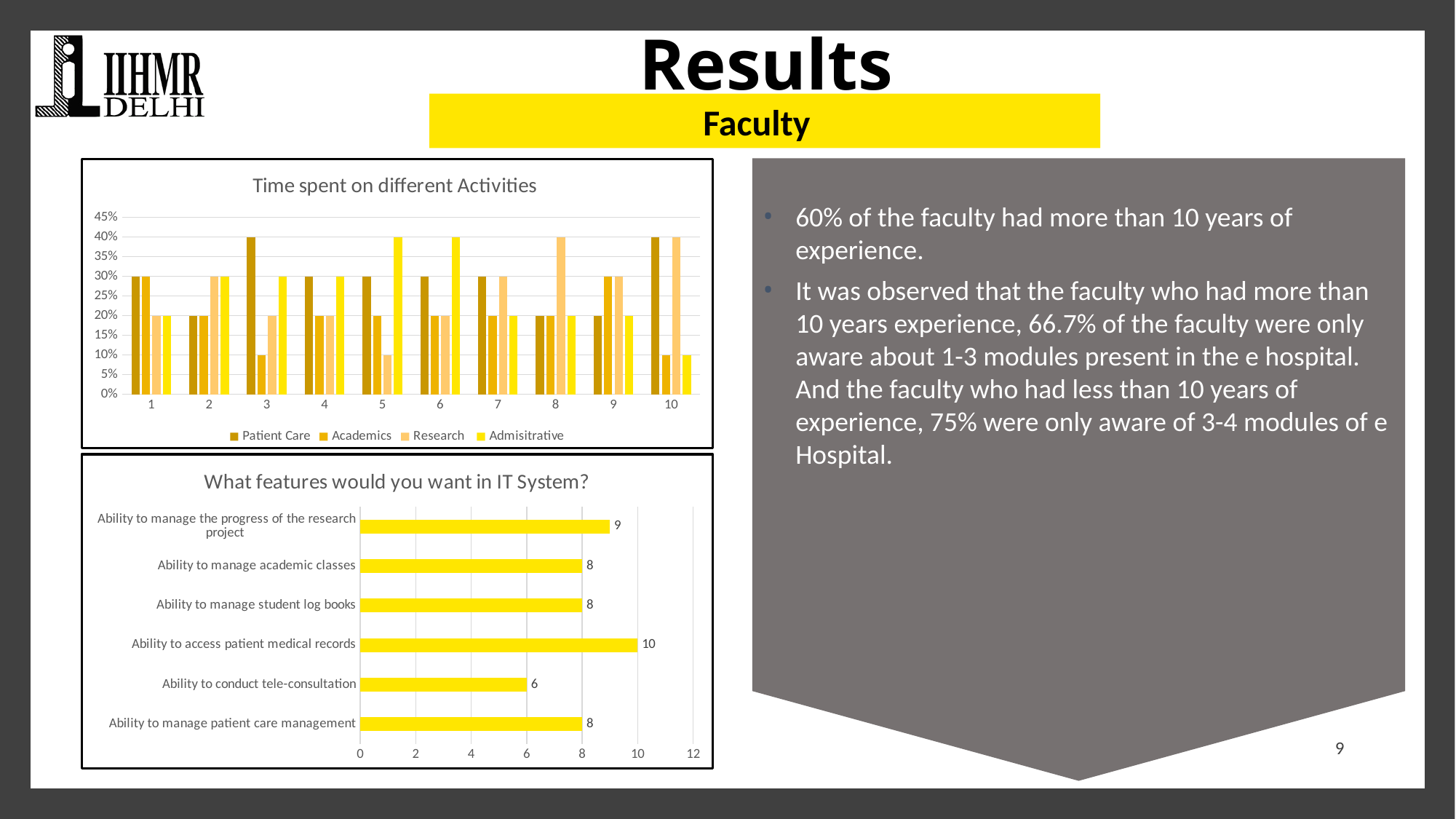
What type of chart is 'What features would you want in IT System?'? Bar chart In the chart 'Time spent on different Activities', is the Academics value for category 10 greater or less than 20%? less In the chart 'Time spent on different Activities', how many categories are shown on the x axis? 10 In the chart 'Time spent on different Activities', is the Patient Care value for category 3 greater or less than 30%? greater In the chart 'What features would you want in IT System?', what is the value for 'Ability to access patient medical records'? 10 In the chart 'What features would you want in IT System?', which feature has the highest value? Ability to access patient medical records In the chart 'Time spent on different Activities', how many series does the legend list? 4 In the chart 'What features would you want in IT System?', which feature has the lowest value? Ability to conduct tele-consultation In the chart 'What features would you want in IT System?', what is the value for 'Ability to conduct tele-consultation'? 6 In the chart 'What features would you want in IT System?', what is the difference between the values for 'Ability to access patient medical records' and 'Ability to conduct tele-consultation'? 4 In the chart 'What features would you want in IT System?', how many features are listed? 6